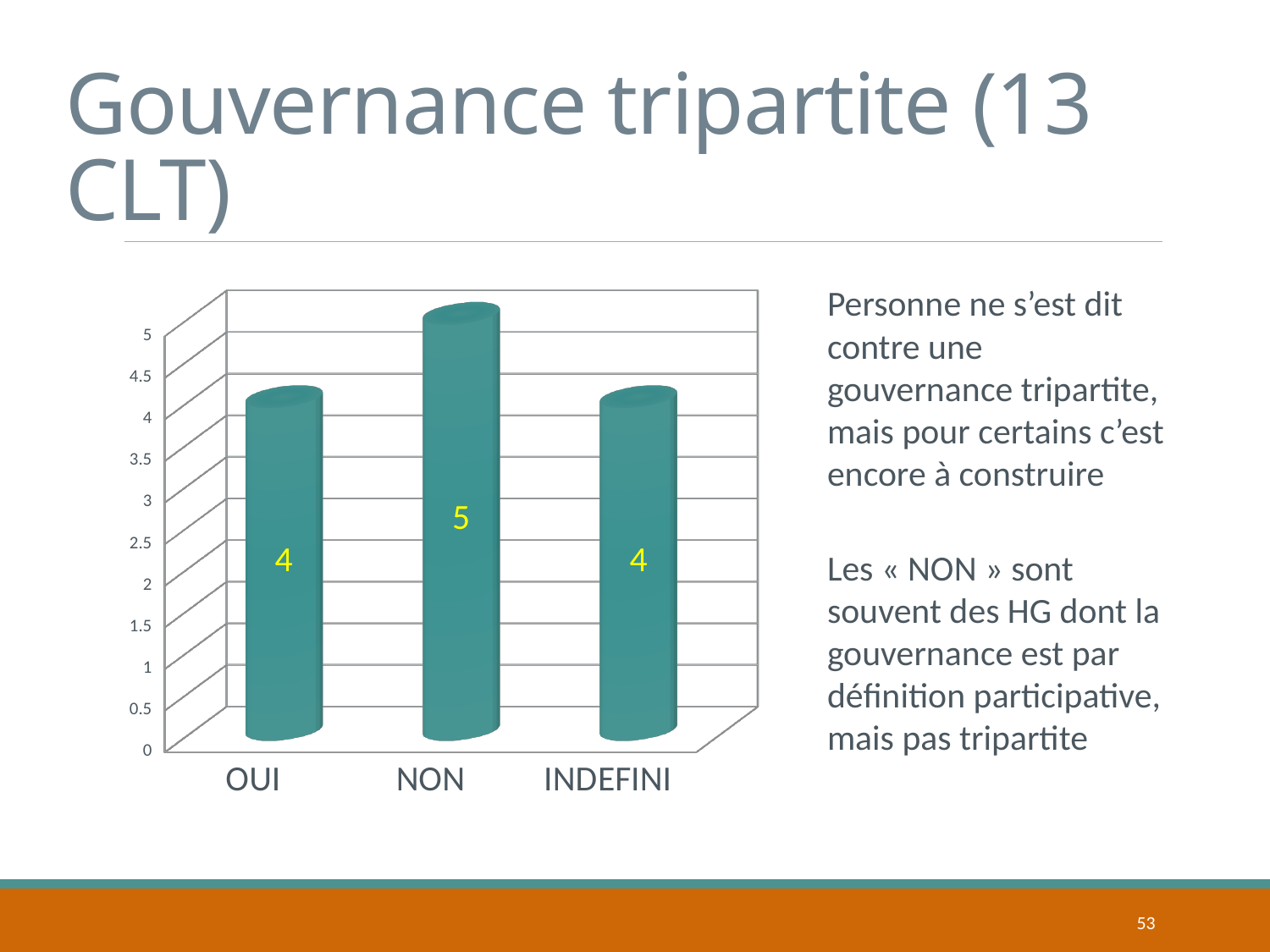
What kind of chart is shown on the slide? bar chart How many categories are shown on the x axis? 3 Is the value for NON greater or less than 4.5? greater What is the value for OUI? 4 What is the value for INDEFINI? 4 Is the value for OUI greater or less than 4.5? less What is the title of the slide containing the chart? Gouvernance tripartite (13 CLT) What is the difference between the values for NON and OUI? 1 Which category has the highest value? NON Which is larger, the value for NON or the value for INDEFINI? NON What is the total of the values for OUI, NON and INDEFINI? 13 What is the value for NON? 5